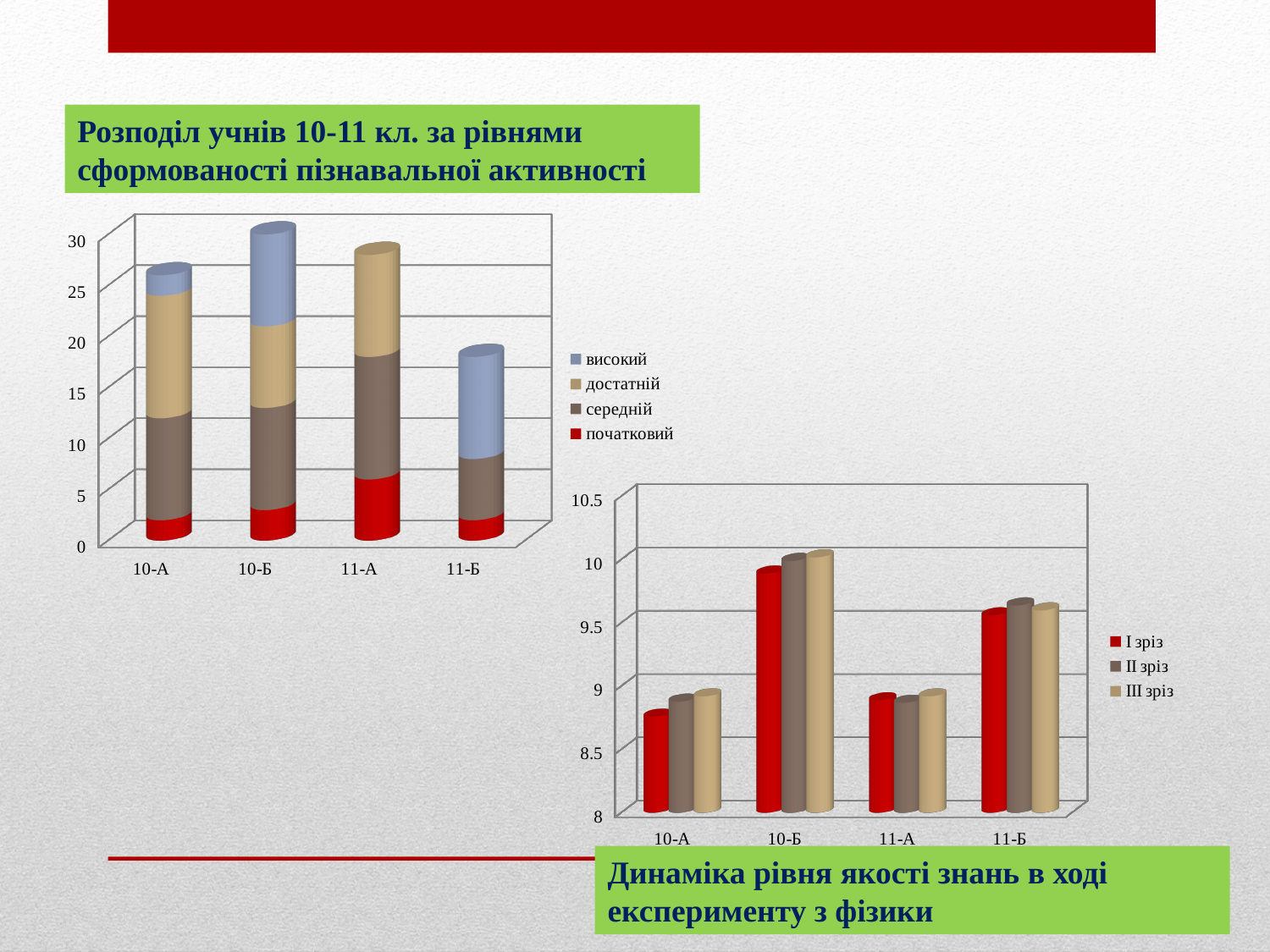
In the chart titled "Розподіл учнів 10-11 кл. за рівнями сформованості пізнавальної активності", which class has the shortest stacked bar? 11-Б What kind of chart is the chart titled "Динаміка рівня якості знань в ході експерименту з фізики"? Bar chart In the chart titled "Розподіл учнів 10-11 кл. за рівнями сформованості пізнавальної активності", which legend entry is shown in red? початковий In the chart titled "Динаміка рівня якості знань в ході експерименту з фізики", is the I зріз value for 10-А greater or less than 9? less How many series does the legend list in the chart titled "Розподіл учнів 10-11 кл. за рівнями сформованості пізнавальної активності"? 4 In the chart titled "Динаміка рівня якості знань в ході експерименту з фізики", which class has the highest value for I зріз? 10-Б In the chart titled "Розподіл учнів 10-11 кл. за рівнями сформованості пізнавальної активності", which class has the tallest stacked bar? 10-Б In the chart titled "Динаміка рівня якості знань в ході експерименту з фізики", which is larger for I зріз: 10-Б or 11-Б? 10-Б How many categories are shown on the x axis of the chart titled "Розподіл учнів 10-11 кл. за рівнями сформованості пізнавальної активності"? 4 How many series does the legend list in the chart titled "Динаміка рівня якості знань в ході експерименту з фізики"? 3 In the chart titled "Розподіл учнів 10-11 кл. за рівнями сформованості пізнавальної активності", is the total for 10-Б greater or less than 25? greater What kind of chart is the chart titled "Розподіл учнів 10-11 кл. за рівнями сформованості пізнавальної активності"? Stacked bar chart